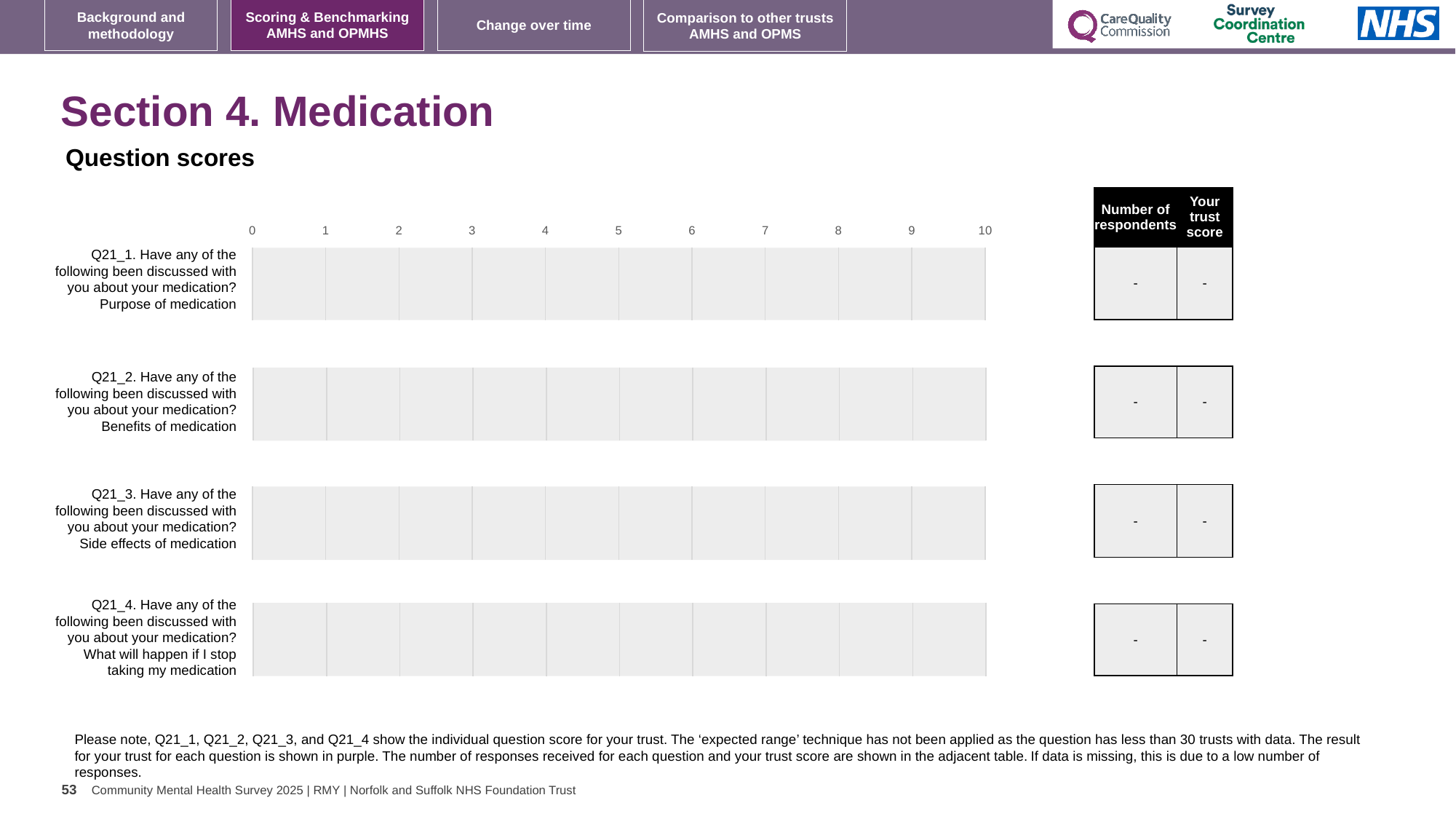
What kind of chart is used on the slide for the Question scores? bar chart What is the trust score shown for Q21_3 in the adjacent table? - What is the title of the section shown on the slide? Section 4. Medication What is the trust score shown for Q21_4 in the adjacent table? - What is the number of respondents shown for Q21_1 in the adjacent table? - What is the highest value shown on the x axis of the Question scores chart? 10 What is the number of respondents shown for Q21_2 in the adjacent table? - How many questions (categories) are shown in the Question scores chart? 4